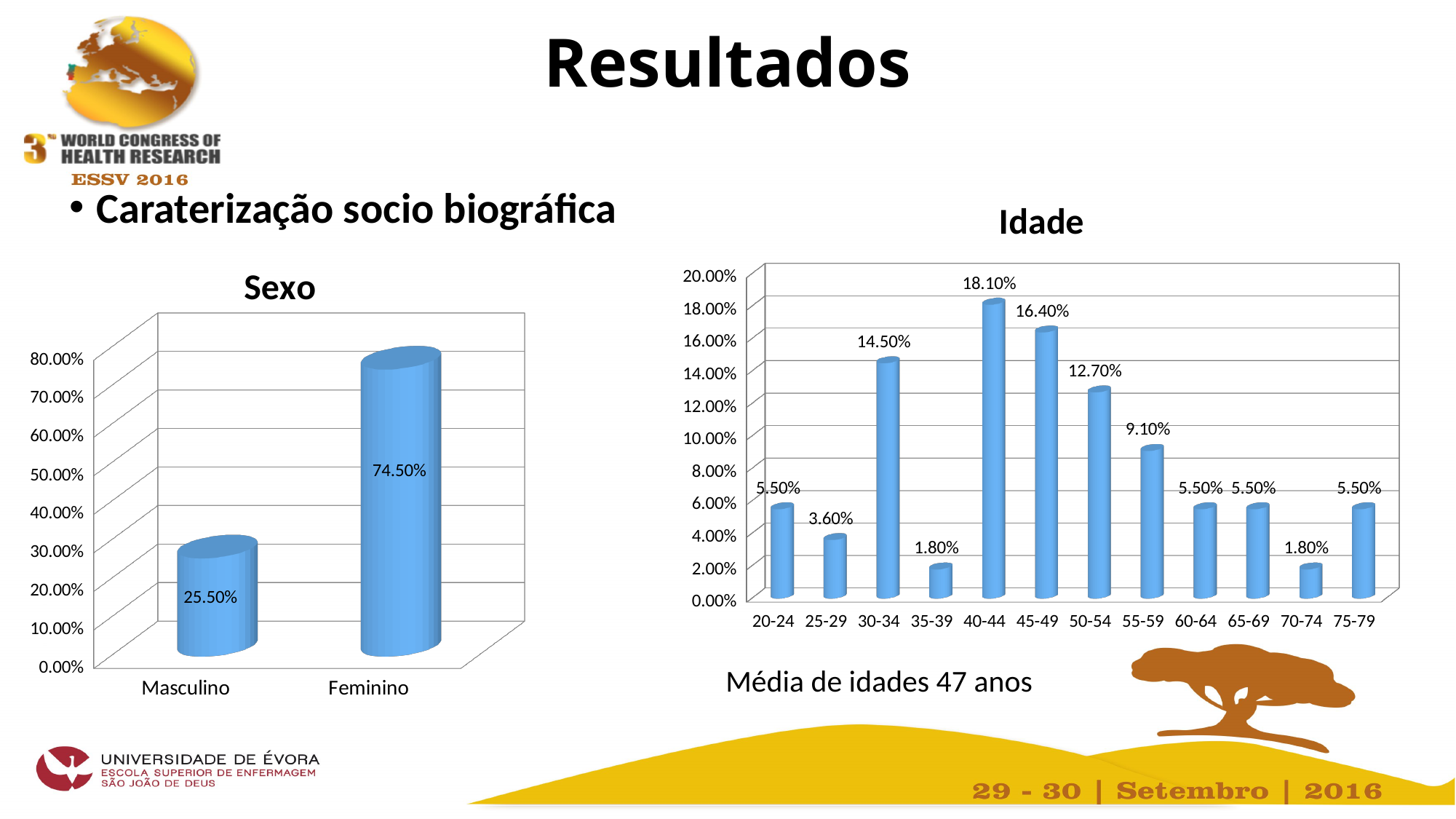
In the 'Idade' chart, which of 30-34 or 50-54 has the larger value? 30-34 In the 'Idade' chart, is the value for 55-59 greater or less than 10.00%? less In the 'Sexo' chart, how many categories are shown? 2 In the 'Idade' chart, what is the difference between the values for 40-44 and 45-49? 1.70% In the 'Sexo' chart, what is the value for Masculino? 25.50% In the 'Idade' chart, what is the value for the 40-44 age group? 18.10% In the 'Sexo' chart, what is the value for Feminino? 74.50% In the 'Idade' chart, how many age groups are shown on the x axis? 12 In the 'Idade' chart, what is the value for the 25-29 age group? 3.60% What kind of chart is the 'Idade' chart? Bar chart In the 'Idade' chart, which age group has the highest value? 40-44 In the 'Sexo' chart, what is the difference between the Feminino and Masculino values? 49.00%